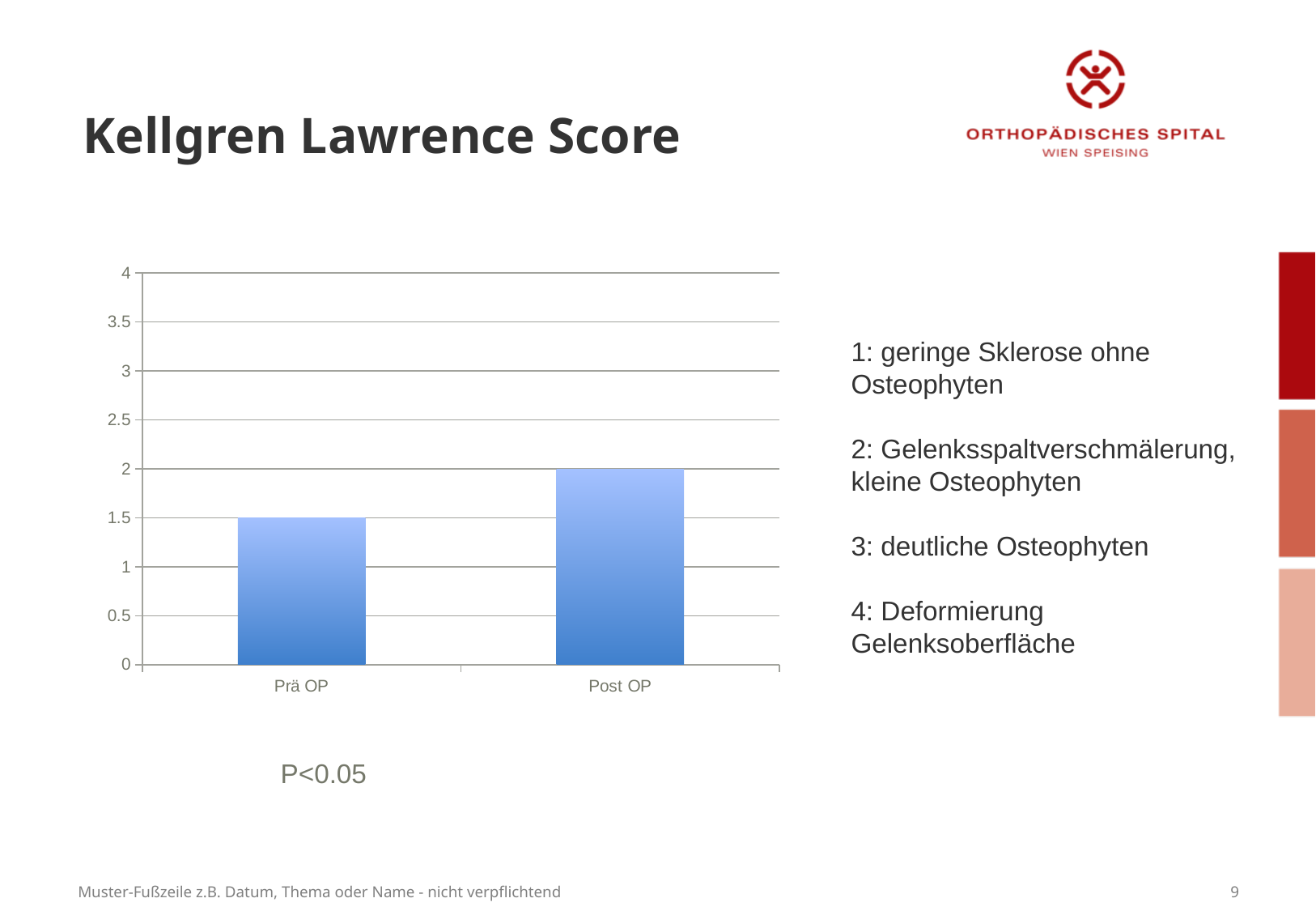
How many categories are shown on the x axis of the chart? 2 What kind of chart is shown on the slide? bar chart Do the values rise or fall from Prä OP to Post OP? rise Is the value for Prä OP greater or less than 1? greater What is the value for Prä OP? 1.5 What is the difference between the Post OP and Prä OP values? 0.5 What is the value for Post OP? 2 Which category has the lowest value? Prä OP Which is larger, the value for Prä OP or the value for Post OP? Post OP What is the maximum value shown on the y axis of the chart? 4 Which category has the highest value? Post OP Is the value for Post OP greater or less than 3? less